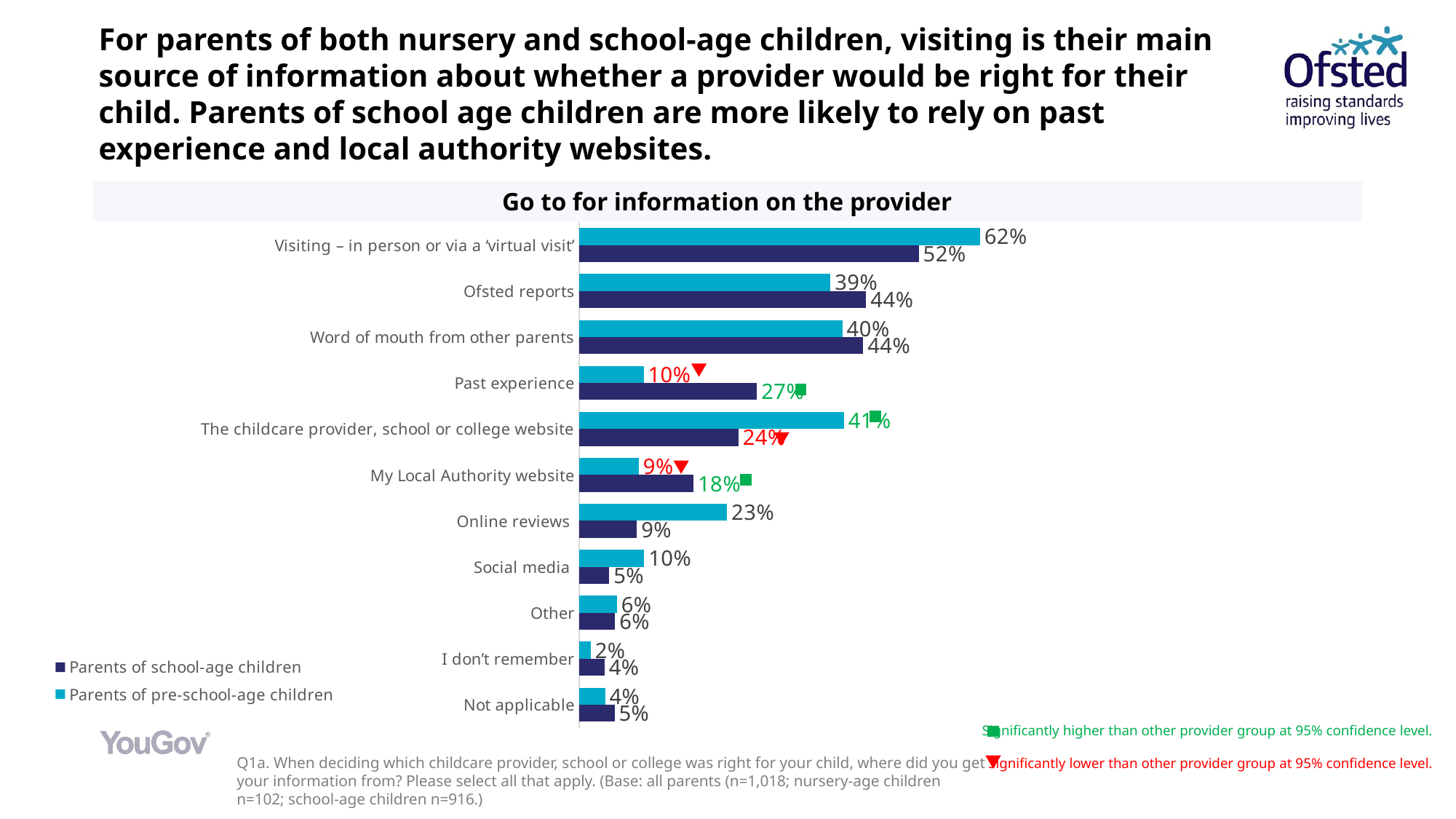
What percentage of parents of pre-school-age children go to 'Online reviews' for information on the provider? 23% What is the difference between parents of school-age children and parents of pre-school-age children for 'My Local Authority website'? 9% Which category has the lowest value for parents of pre-school-age children? I don’t remember What is the title of the chart? Go to for information on the provider What is the difference between the two groups for 'Visiting – in person or via a virtual visit'? 10% What percentage of parents of pre-school-age children go to 'Visiting – in person or via a virtual visit' for information on the provider? 62% How many categories are shown on the chart? 11 What kind of chart is shown on the slide? bar chart What percentage of parents of school-age children go to 'Past experience' for information on the provider? 27% How many series does the legend list? 2 Which category has the highest value for parents of school-age children? Visiting – in person or via a ‘virtual visit’ For 'The childcare provider, school or college website', which group has the larger value: parents of school-age children or parents of pre-school-age children? Parents of pre-school-age children